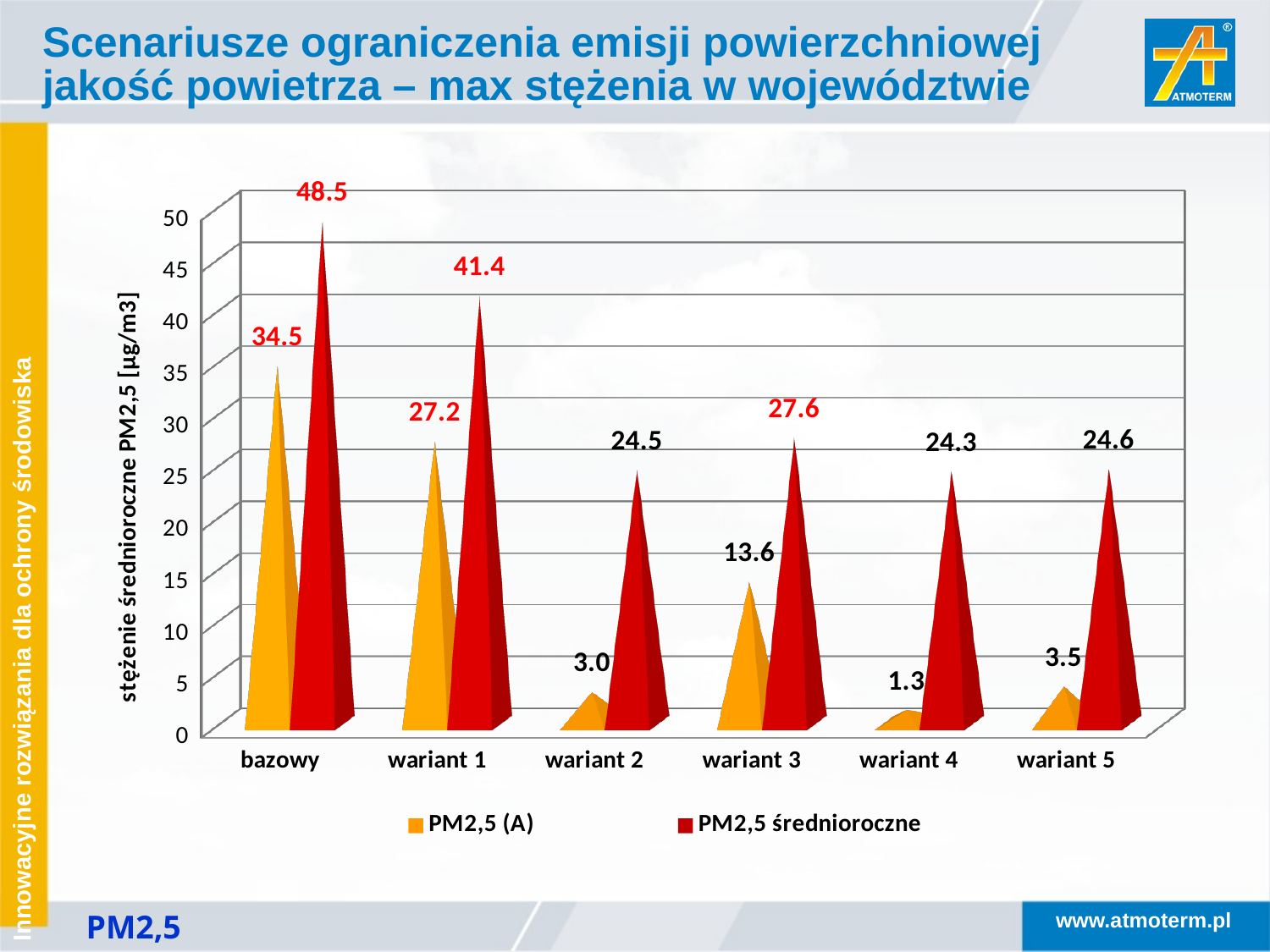
How many series does the legend list? 2 How many categories are shown on the x axis? 6 What is the PM2,5 (A) value for wariant 4? 1.3 What is the label of the vertical axis? stężenie średnioroczne PM2,5 [µg/m3] What is the PM2,5 średnioroczne value for wariant 1? 41.4 What kind of chart is shown on the slide? bar chart What is the PM2,5 (A) value for wariant 3? 13.6 What is the difference between the PM2,5 średnioroczne values for bazowy and wariant 1? 7.1 What is the PM2,5 średnioroczne value for bazowy? 48.5 Which category has the lowest PM2,5 (A) value? wariant 4 Which category has the highest PM2,5 średnioroczne value? bazowy Which is larger: the PM2,5 (A) value for wariant 2 or for wariant 5? wariant 5